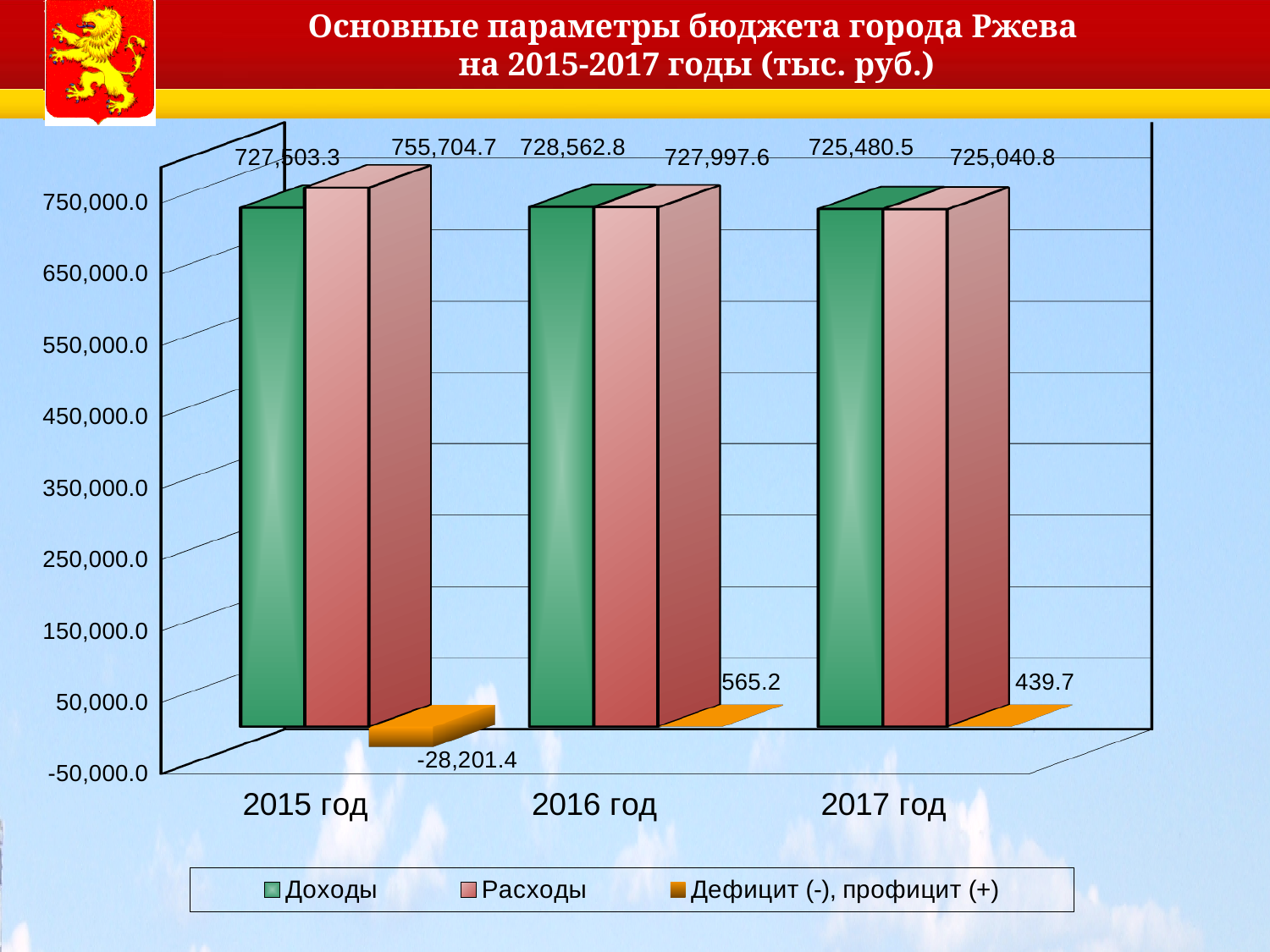
How many years are shown on the x axis? 3 How many series does the legend list? 3 Do the Расходы values rise or fall from 2015 год to 2017 год? fall What is the difference between Доходы and Расходы for 2016 год? 565.2 What is the value of Дефицит (-), профицит (+) for 2015 год? -28,201.4 In which year is Расходы the highest? 2015 год What is the value of Доходы for 2016 год? 728,562.8 What is the value of Расходы for 2015 год? 755,704.7 What kind of chart is shown on the slide? bar chart For 2017 год, which is larger: Доходы or Расходы? Доходы In which year is Доходы the lowest? 2017 год What is the value of Расходы for 2017 год? 725,040.8